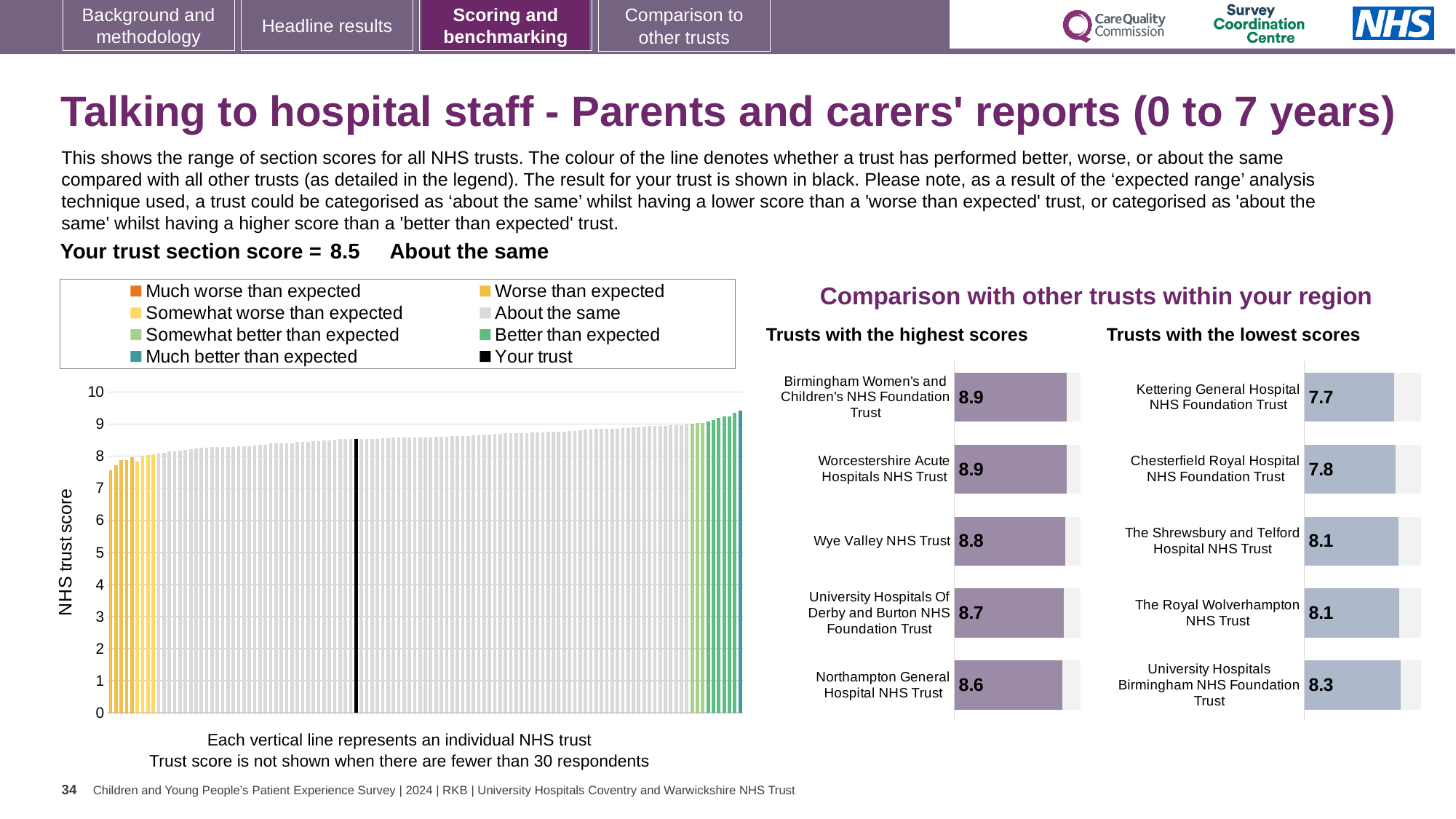
In the 'Trusts with the lowest scores' chart, which trust has the highest score shown? University Hospitals Birmingham NHS Foundation Trust Which has the higher score: Wye Valley NHS Trust in the highest scores chart or Chesterfield Royal Hospital NHS Foundation Trust in the lowest scores chart? Wye Valley NHS Trust In the 'Trusts with the highest scores' chart, which trust has the lowest score shown? Northampton General Hospital NHS Trust In the 'Trusts with the lowest scores' chart, what is the score for Kettering General Hospital NHS Foundation Trust? 7.7 In the 'Trusts with the highest scores' chart, what is the score for Northampton General Hospital NHS Trust? 8.6 In the main 'NHS trust score' chart, how many entries does the legend list? 8 In the 'Trusts with the lowest scores' chart, what is the difference between the scores of University Hospitals Birmingham NHS Foundation Trust and Kettering General Hospital NHS Foundation Trust? 0.6 In the main 'NHS trust score' chart, do the trust scores rise or fall from left to right? Rise In the 'Trusts with the lowest scores' chart, how many trusts are listed? 5 In the 'Trusts with the highest scores' chart, what is the score for Wye Valley NHS Trust? 8.8 What kind of chart is the main 'NHS trust score' chart on the left? Bar chart In the main 'NHS trust score' chart, is the value for the leftmost (lowest) trust greater or less than 8? less